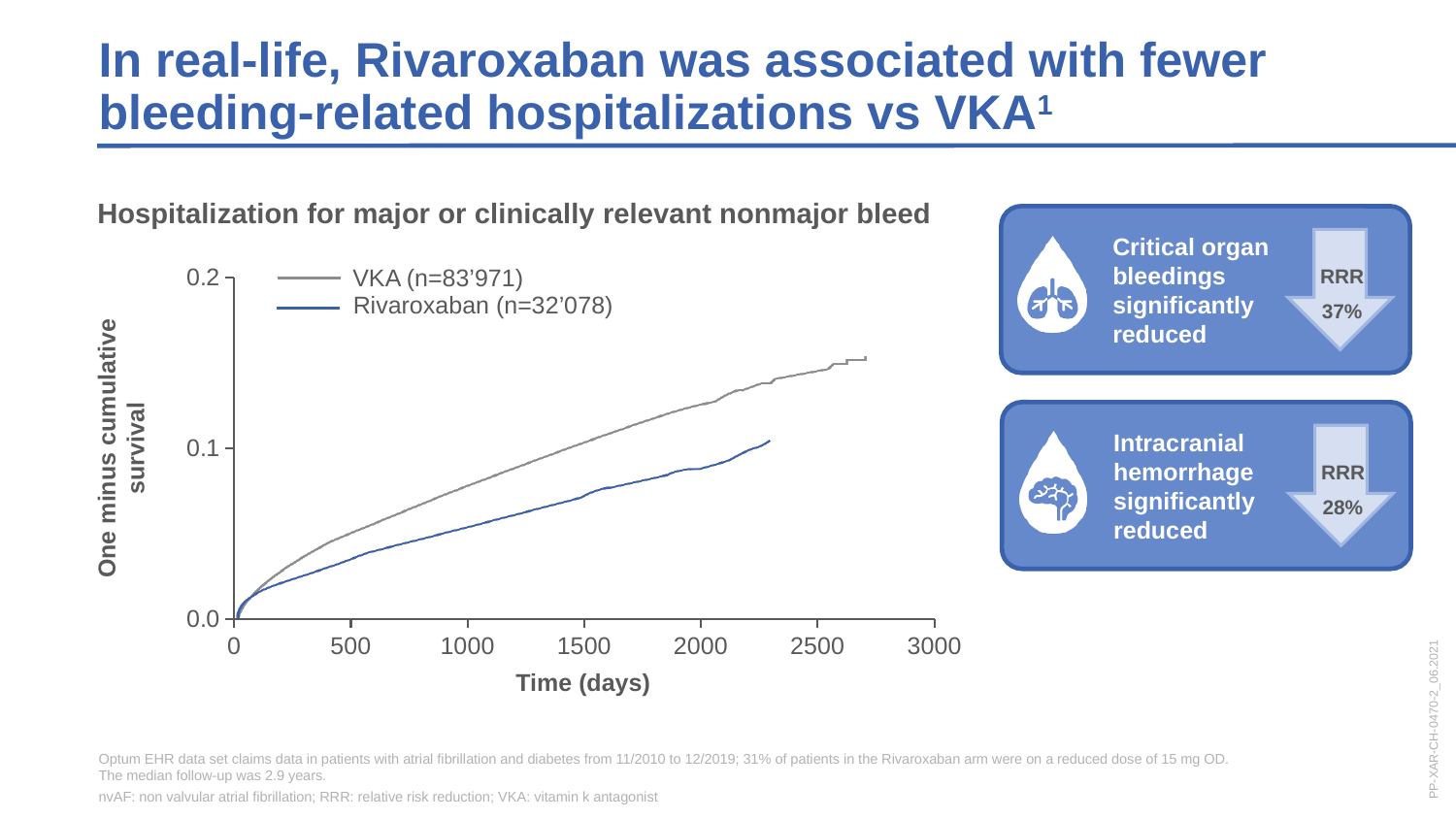
How many series does the chart legend list? 2 Do the values for the VKA series rise or fall as time increases? rise Is the value for Rivaroxaban at 2000 days greater or less than 0.1? less Which series reaches the highest value on the chart? VKA Is the value for VKA at 2500 days greater or less than 0.1? greater What is the title of the chart? Hospitalization for major or clinically relevant nonmajor bleed Which series has the higher value at 2000 days, VKA or Rivaroxaban? VKA Do the values for the Rivaroxaban series rise or fall as time increases? rise What kind of chart is shown on the slide? Line chart What is the label of the x axis of the chart? Time (days) Is the value for Rivaroxaban at 500 days greater or less than 0.1? less